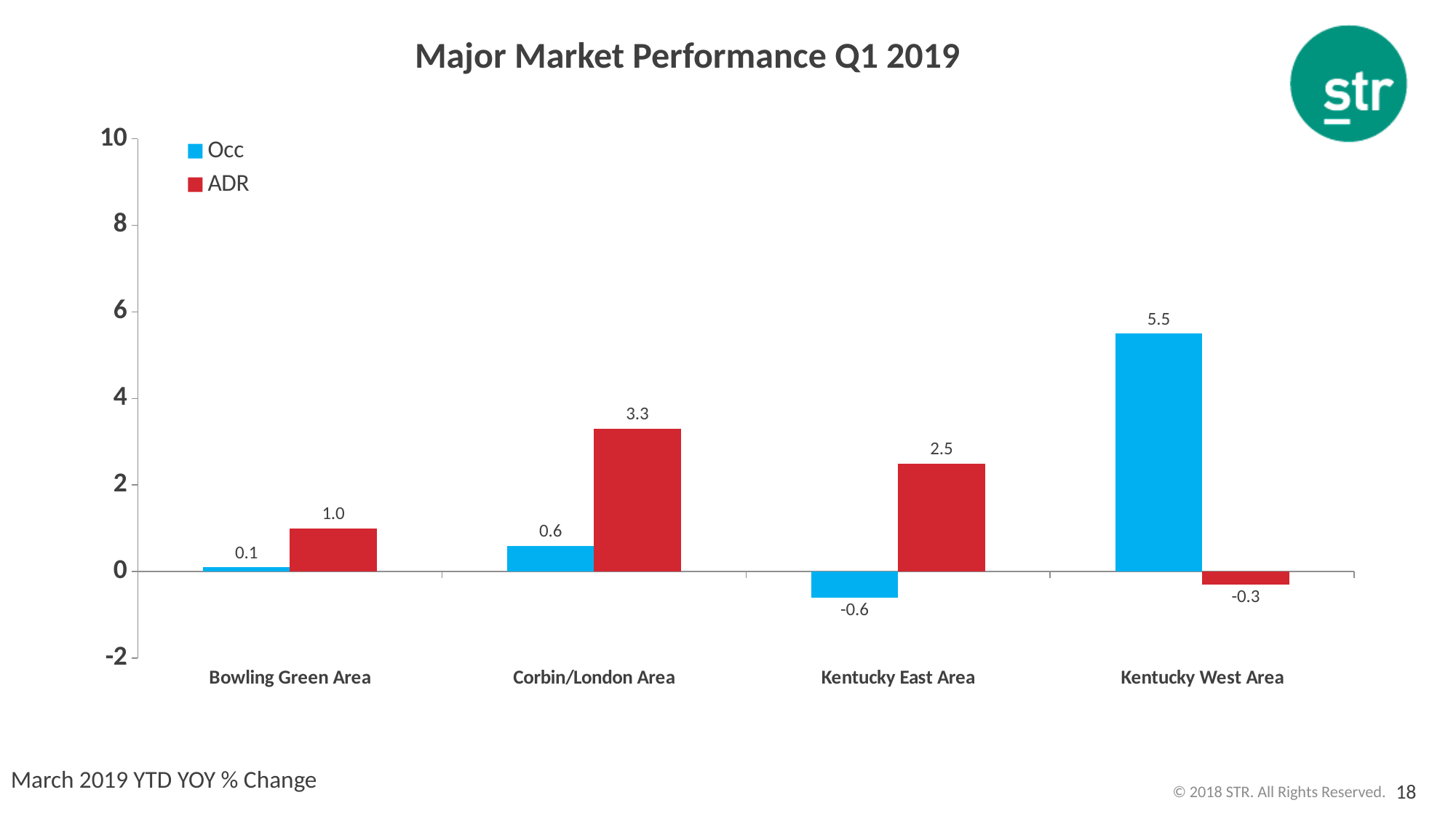
Is the Occ value for Kentucky West Area greater or less than 4? greater Which area has the highest ADR value? Corbin/London Area Which is larger for Corbin/London Area, Occ or ADR? ADR Which area has the lowest Occ value? Kentucky East Area How many series does the legend list? 2 What is the Occ value for Kentucky East Area? -0.6 How many areas are shown on the x axis? 4 What is the Occ value for Kentucky West Area? 5.5 What is the ADR value for Bowling Green Area? 1.0 What is the difference between the ADR and Occ values for Kentucky East Area? 3.1 What kind of chart is shown on the slide? Bar chart What is the ADR value for Corbin/London Area? 3.3